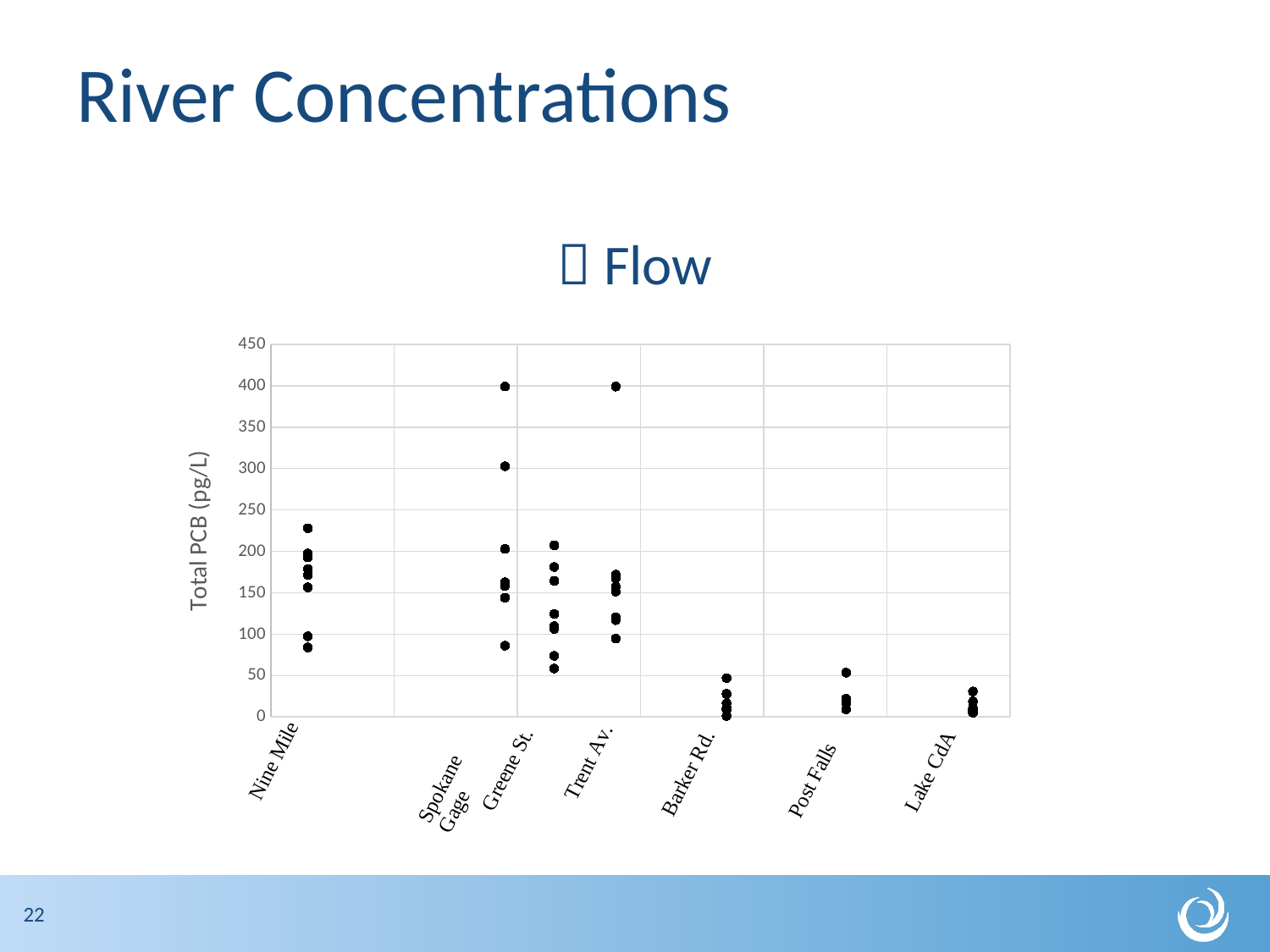
Is the highest value for Trent Av. greater or less than 350? greater What kind of chart is shown on the slide? scatter chart Which site has the larger highest value, Nine Mile or Post Falls? Nine Mile Are all the values for Barker Rd. greater or less than 100? less Moving from Nine Mile on the left to Lake CdA on the right, do the plotted values generally rise or fall? fall How many site categories are labelled on the x axis? 7 Is the highest value for Nine Mile greater or less than 200? greater What is the maximum value shown on the y axis? 450 What is the label of the y axis? Total PCB (pg/L)